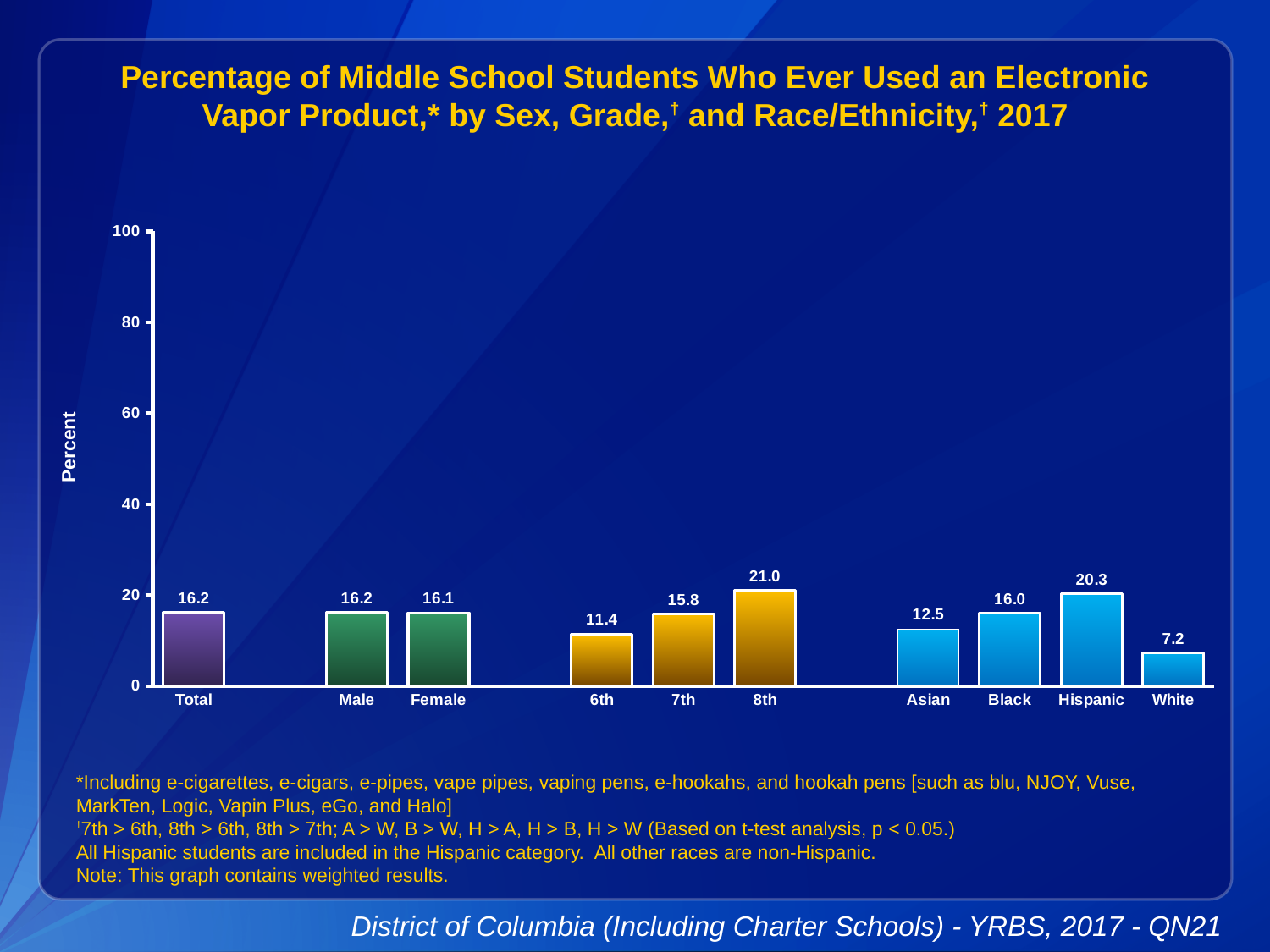
What is the difference between the values for 8th and 6th grade? 9.6 Which is larger, the value for Asian students or the value for Black students? Black What is the value for White students? 7.2 What kind of chart is shown on the slide? bar chart What is the value for Total? 16.2 What is the value for 8th grade students? 21.0 How many categories are shown on the x axis? 10 What is the difference between the values for Hispanic and White students? 13.1 Which category has the highest value? 8th What is the value for Hispanic students? 20.3 Is the value for 8th grade greater or less than 20? greater Which category has the lowest value? White